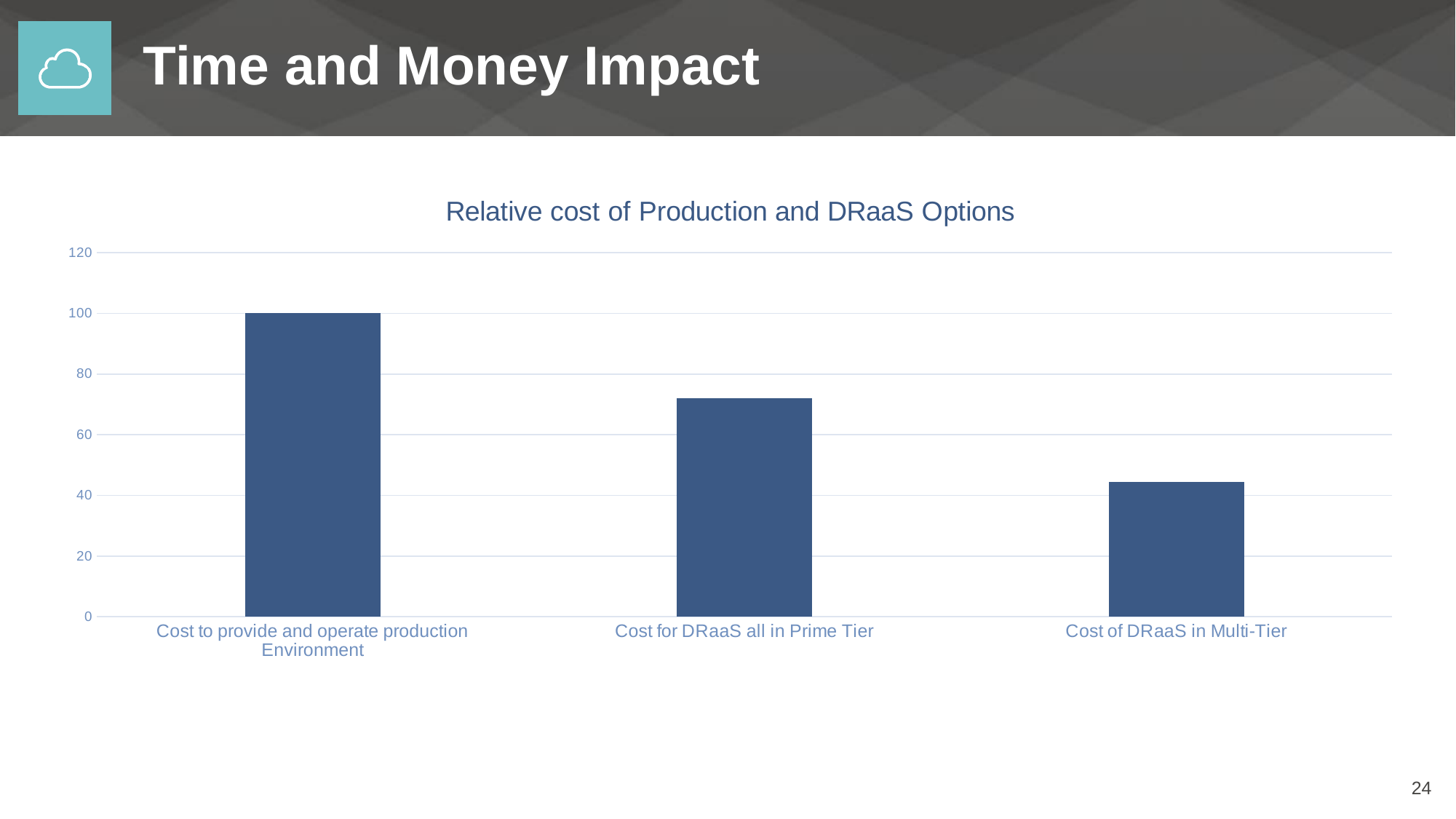
How many categories are plotted in the chart? 3 Is the value for 'Cost for DRaaS all in Prime Tier' greater or less than 60? greater Do the values rise or fall from left to right across the categories? fall Is the value for 'Cost of DRaaS in Multi-Tier' greater or less than 60? less What is the title of the chart? Relative cost of Production and DRaaS Options Is the value for 'Cost of DRaaS in Multi-Tier' greater or less than 40? greater Which category has the highest value? Cost to provide and operate production Environment What type of chart is shown on the slide? bar chart Which category has the lowest value? Cost of DRaaS in Multi-Tier What is the value for 'Cost to provide and operate production Environment'? 100 Which is larger: the value for 'Cost for DRaaS all in Prime Tier' or the value for 'Cost of DRaaS in Multi-Tier'? Cost for DRaaS all in Prime Tier